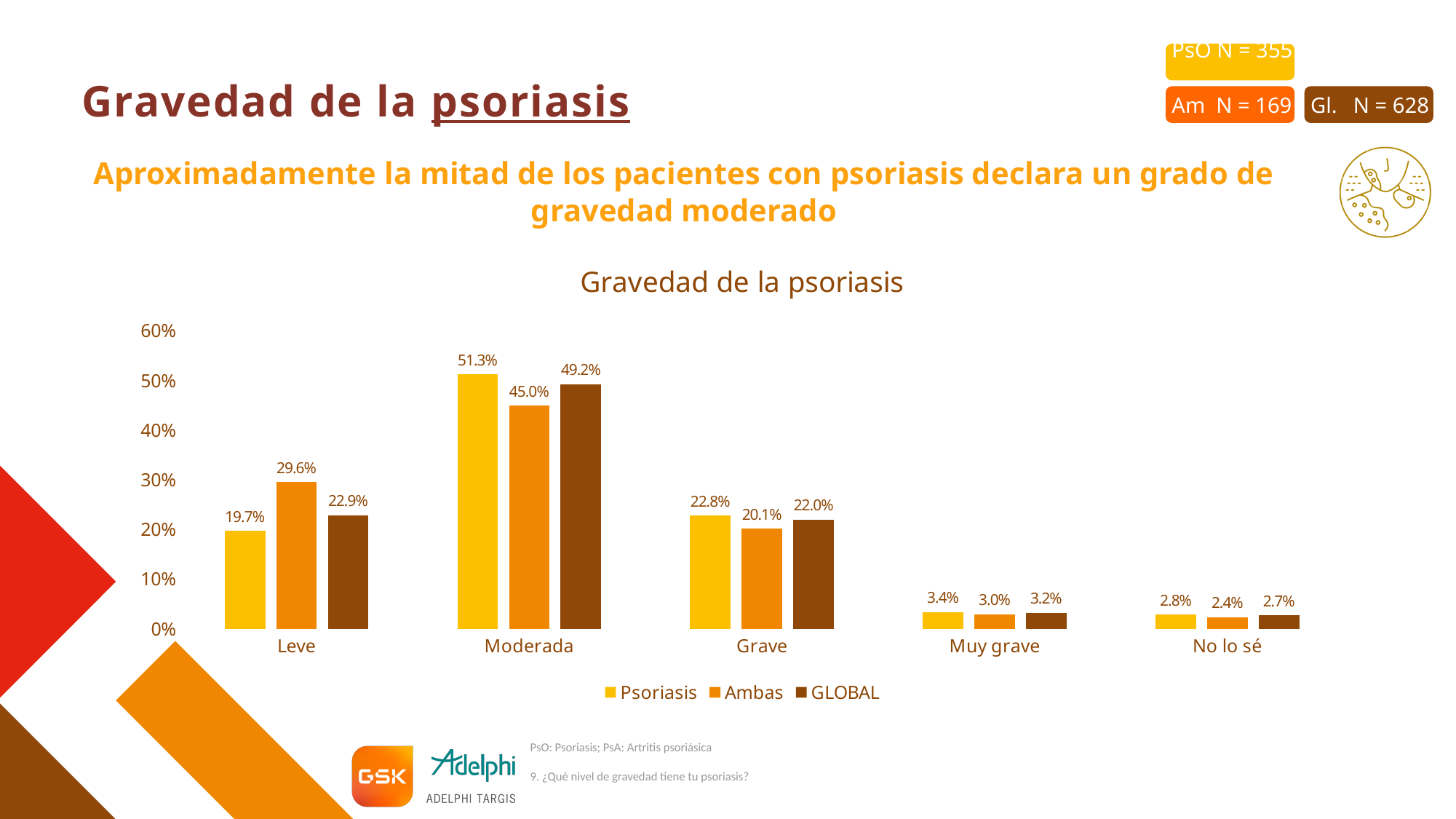
What is the title of the chart? Gravedad de la psoriasis What is the value for Ambas in the No lo sé category? 2.4% Which category has the lowest Psoriasis value? No lo sé What is the value for Psoriasis in the Moderada category? 51.3% Which category has the highest GLOBAL value? Moderada What is the GLOBAL value for the Grave category? 22.0% What kind of chart is shown on the slide? Bar chart What is the difference between the Psoriasis and Ambas values in the Moderada category? 6.3% In the Leve category, which series has the larger value: Psoriasis or Ambas? Ambas How many categories are shown on the x axis? 5 How many series does the legend list? 3 What is the value for Ambas in the Leve category? 29.6%